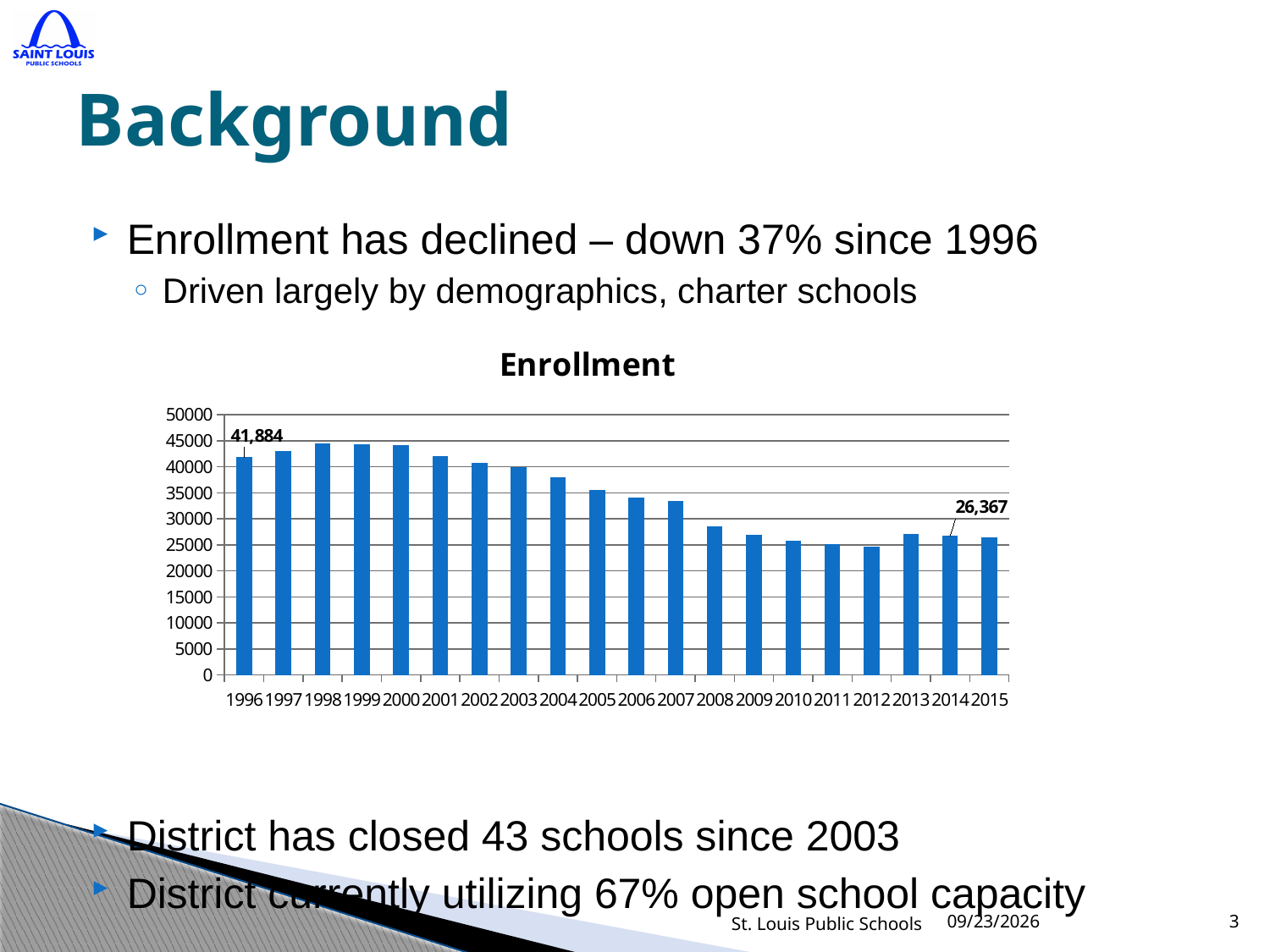
What kind of chart is used to show enrollment? Bar chart Does enrollment generally rise or fall from 1996 to 2015? Fall Is the enrollment value for 2008 greater or less than 30000? less How many years are shown on the x axis of the Enrollment chart? 20 Which year has the larger enrollment, 2003 or 2009? 2003 Is the enrollment value for 2004 greater or less than 35000? greater Which year has the larger enrollment, 1996 or 2014? 1996 What is the enrollment value shown for 1996? 41,884 What is the title of the chart on the slide? Enrollment Is the enrollment value for 2007 greater or less than 30000? greater